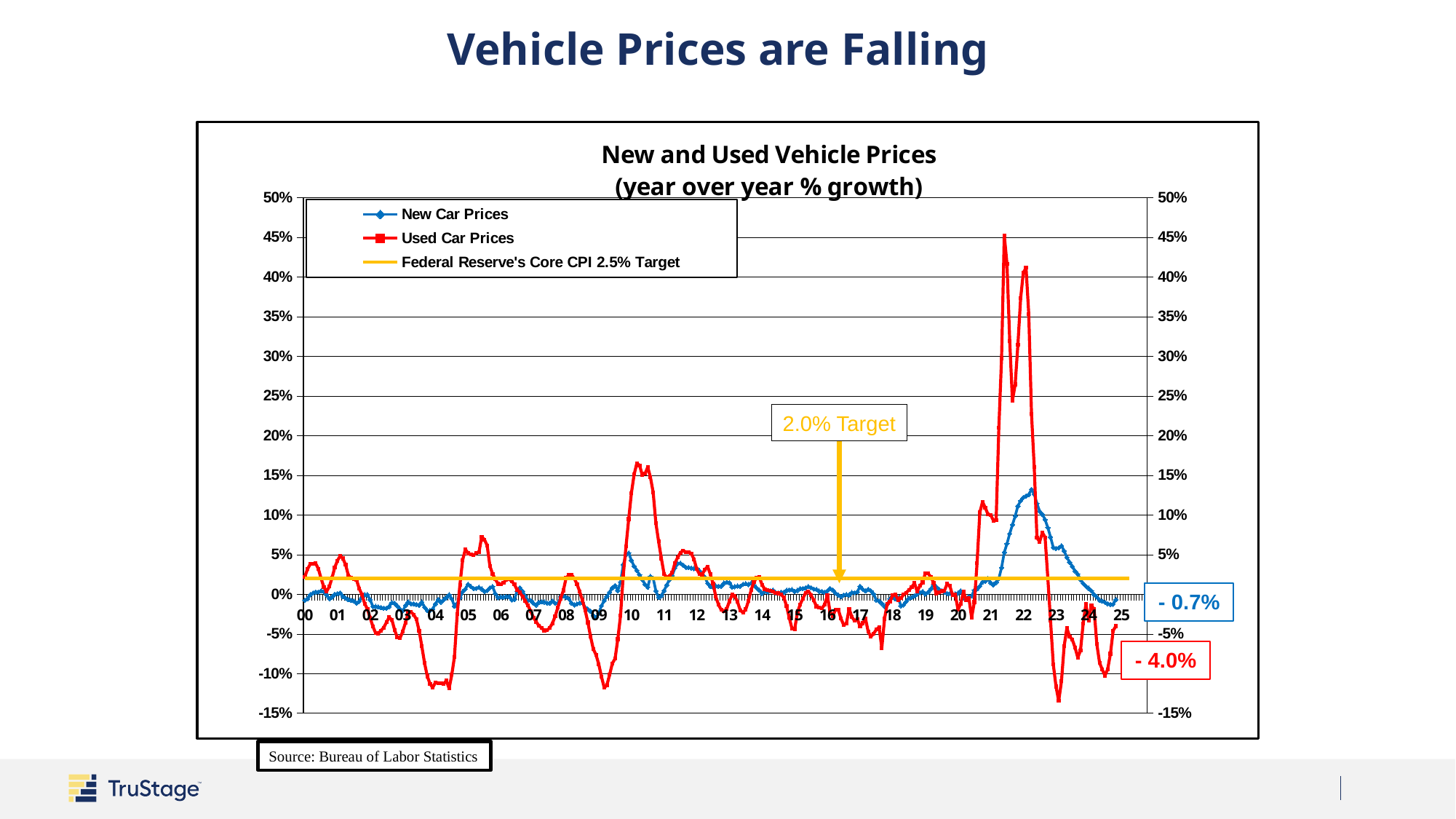
What is the latest labelled value for New Car Prices? -0.7% What kind of chart is shown on the slide? Line chart Which series has the lower latest labelled value, New Car Prices or Used Car Prices? Used Car Prices How many series does the legend list? 3 What is the title of the chart? New and Used Vehicle Prices (year over year % growth) What is the difference between the latest labelled values for New Car Prices (-0.7%) and Used Car Prices (-4.0%)? 3.3 percentage points Do New Car Prices rise or fall from 2022 to 2025? Fall Is the peak value for Used Car Prices around 2021 greater or less than 40%? greater Is the lowest value for Used Car Prices around 2023 greater or less than -10%? less Which series reaches the highest peak on the chart? Used Car Prices Is the peak value for New Car Prices around 2022 greater or less than 10%? greater What is the latest labelled value for Used Car Prices? -4.0%